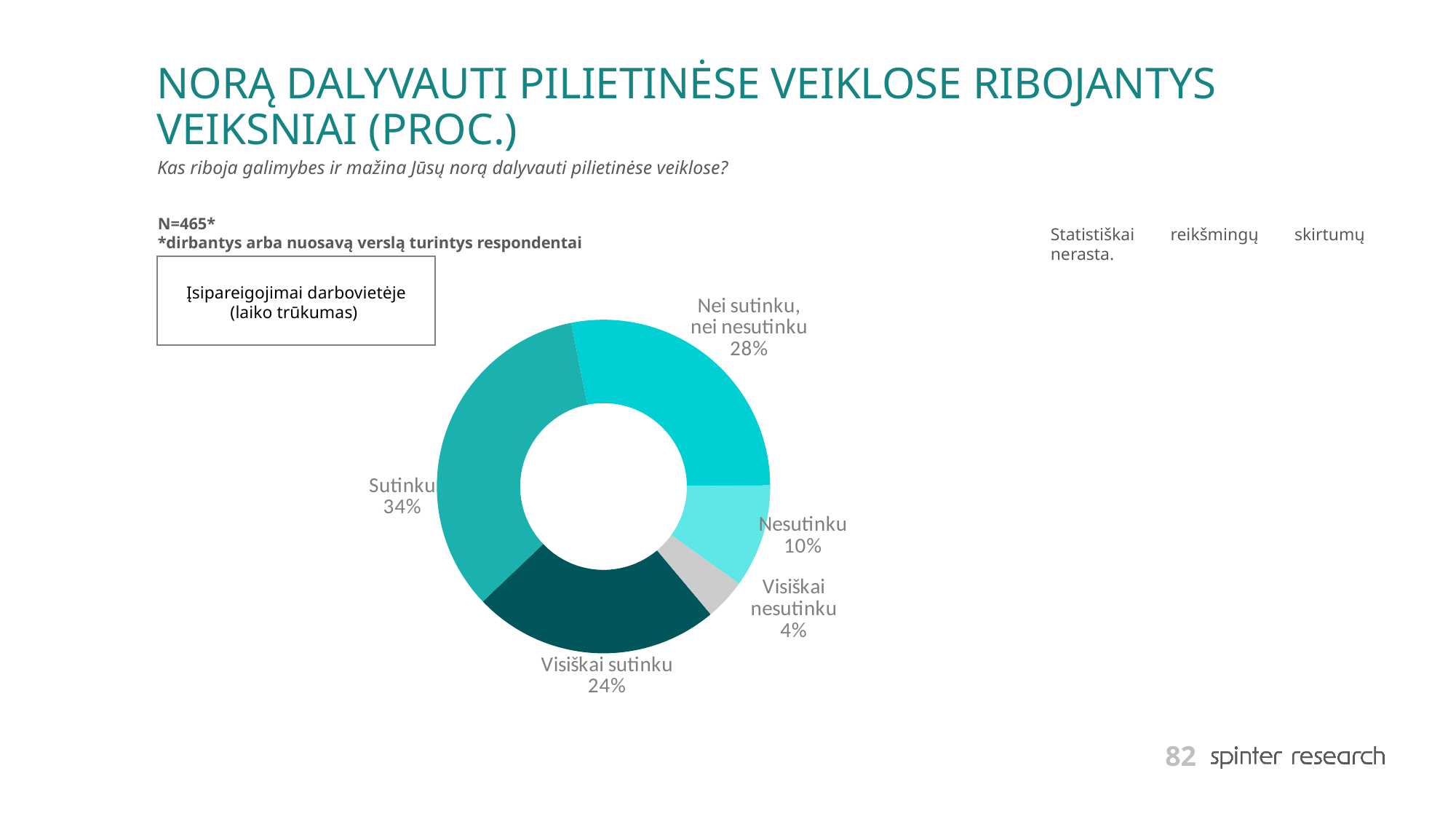
Which response category has the largest share of the pie? Sutinku How many categories are shown in the pie chart? 5 What is the difference in percentage points between "Sutinku" and "Visiškai sutinku"? 10 What is the combined share of "Sutinku" and "Visiškai sutinku"? 58% Which is larger, the share for "Nei sutinku, nei nesutinku" or the share for "Nesutinku"? Nei sutinku, nei nesutinku What percentage of respondents answered "Sutinku"? 34% What percentage is shown for "Visiškai nesutinku"? 4% Which response category has the smallest share of the pie? Visiškai nesutinku What share is shown for "Nei sutinku, nei nesutinku"? 28% What percentage is shown for "Visiškai sutinku"? 24% What percentage is shown for "Nesutinku"? 10% What type of chart is shown on the slide? Doughnut chart